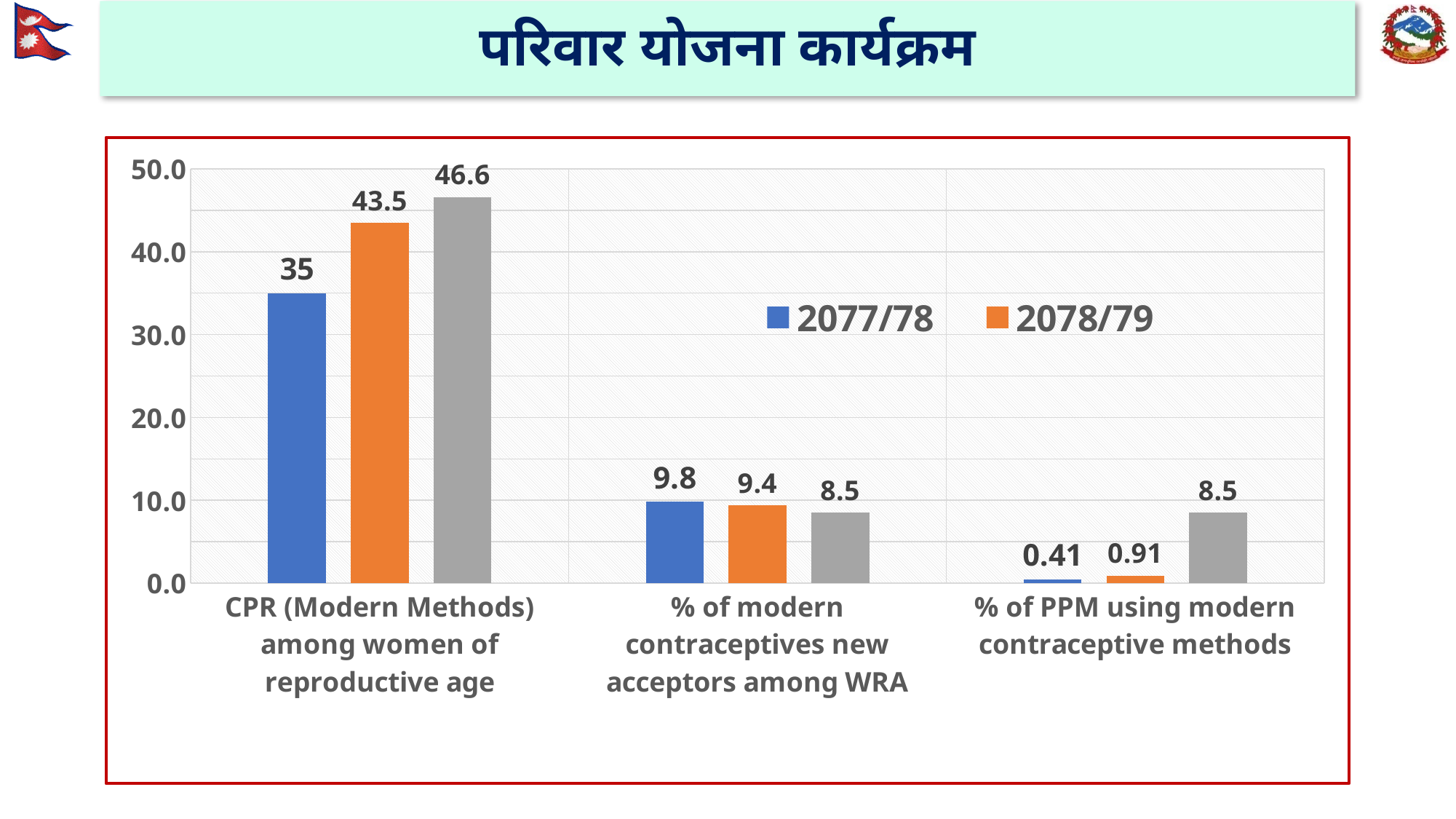
How many categories are shown on the x axis of the chart? 3 What is the 2078/79 value for CPR (Modern Methods) among women of reproductive age? 43.5 Which category has the highest 2078/79 value? CPR (Modern Methods) among women of reproductive age How many series does the chart legend list? 2 What is the 2077/78 value for CPR (Modern Methods) among women of reproductive age? 35 What value is printed on the grey bar for % of PPM using modern contraceptive methods? 8.5 What is the difference between the 2077/78 and 2078/79 values for % of modern contraceptives new acceptors among WRA? 0.4 By how much did CPR (Modern Methods) among women of reproductive age increase from 2077/78 to 2078/79? 8.5 Which category has the lowest 2077/78 value? % of PPM using modern contraceptive methods What is the 2078/79 value for % of PPM using modern contraceptive methods? 0.91 For % of modern contraceptives new acceptors among WRA, which year has the larger value, 2077/78 or 2078/79? 2077/78 What is the 2077/78 value for % of modern contraceptives new acceptors among WRA? 9.8